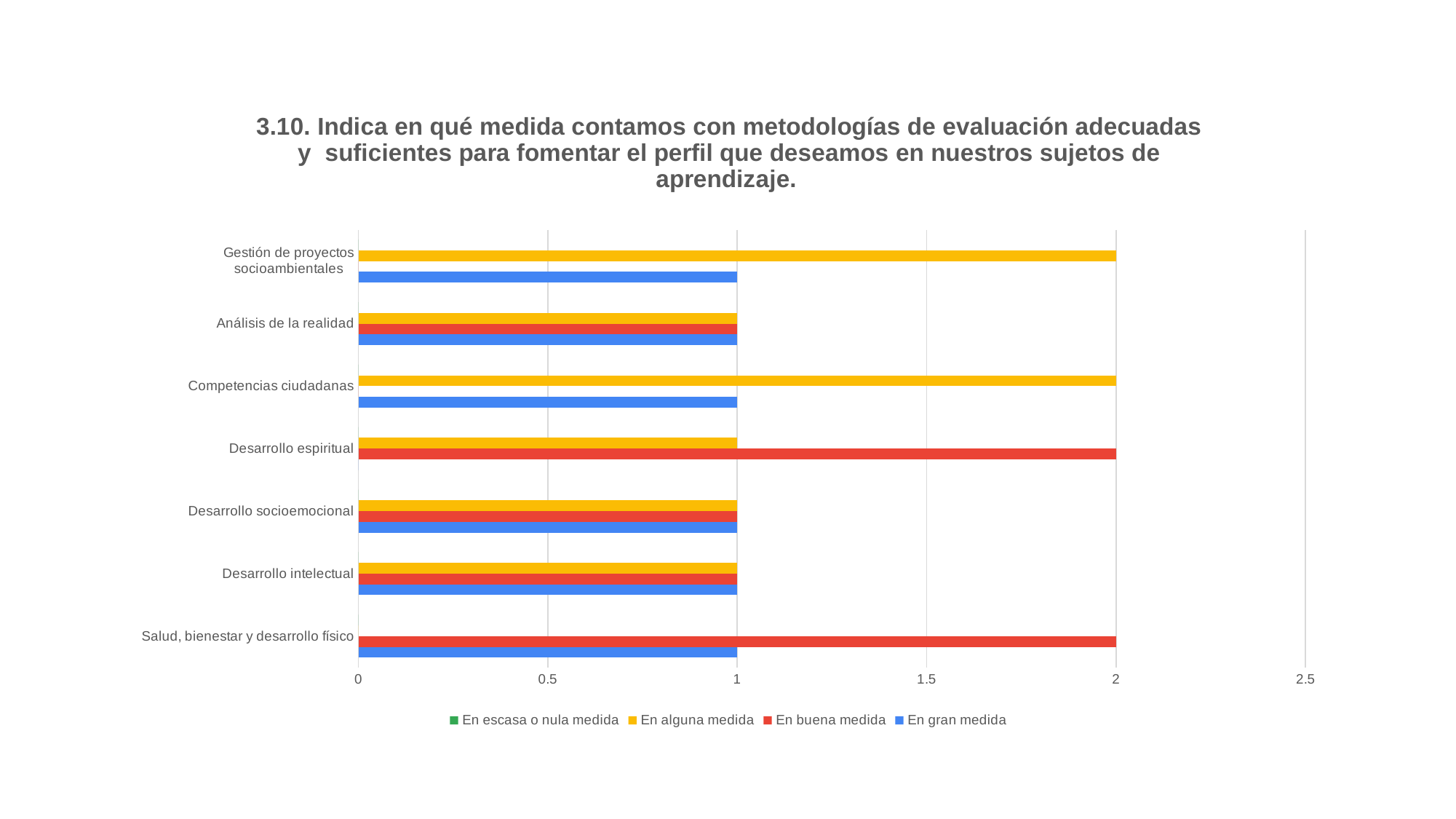
What kind of chart is shown on the slide? bar chart How many series does the legend list? 4 Is the value of "En buena medida" for Salud, bienestar y desarrollo físico greater or less than 1.5? greater What is the value of "En gran medida" for Salud, bienestar y desarrollo físico? 1 What is the value of "En alguna medida" for Competencias ciudadanas? 2 Which is larger for Desarrollo espiritual: "En alguna medida" or "En buena medida"? En buena medida How many categories are listed on the vertical axis of the chart? 7 What is the value of "En buena medida" for Desarrollo espiritual? 2 Which series is shown in red in the legend? En buena medida What is the highest value shown on the horizontal axis? 2.5 What is the difference between "En alguna medida" and "En gran medida" for Gestión de proyectos socioambientales? 1 What is the value of "En alguna medida" for Gestión de proyectos socioambientales? 2